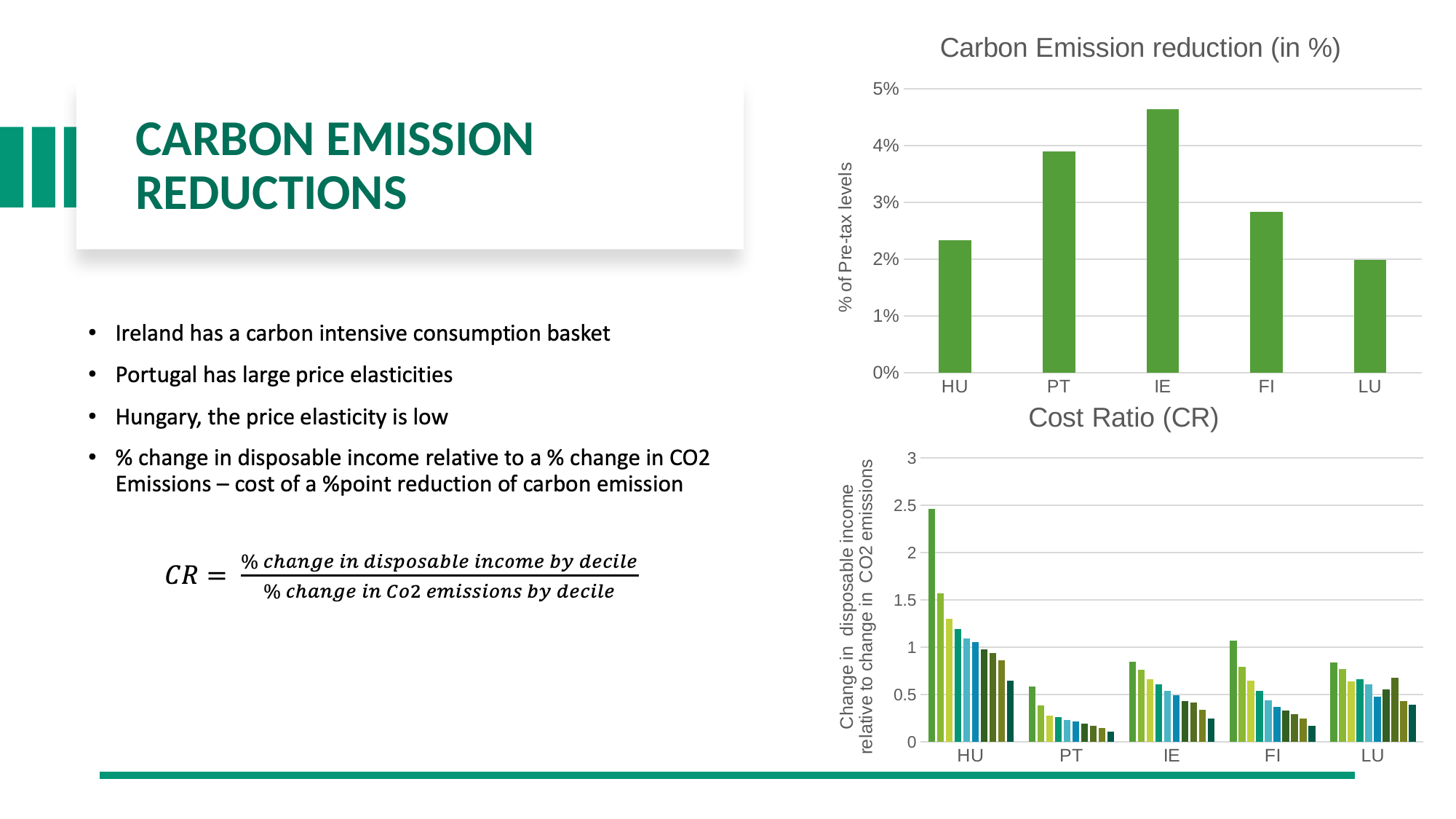
In the 'Cost Ratio (CR)' chart, how many countries are shown on the x axis? 5 In the 'Carbon Emission reduction (in %)' chart, how many countries are shown on the x axis? 5 What is the y-axis label of the 'Carbon Emission reduction (in %)' chart? % of Pre-tax levels In the 'Carbon Emission reduction (in %)' chart, which country has the lowest carbon emission reduction? LU What type of chart is the 'Carbon Emission reduction (in %)' chart? bar chart In the 'Carbon Emission reduction (in %)' chart, is the value for IE greater or less than 4%? greater In the 'Carbon Emission reduction (in %)' chart, which is larger, the value for PT or the value for FI? PT In the 'Carbon Emission reduction (in %)' chart, is the value for PT greater or less than 3%? greater In the 'Cost Ratio (CR)' chart, is the tallest bar in the HU group greater or less than 2? greater In the 'Cost Ratio (CR)' chart, which country contains the tallest bar? HU In the 'Carbon Emission reduction (in %)' chart, which country has the highest carbon emission reduction? IE